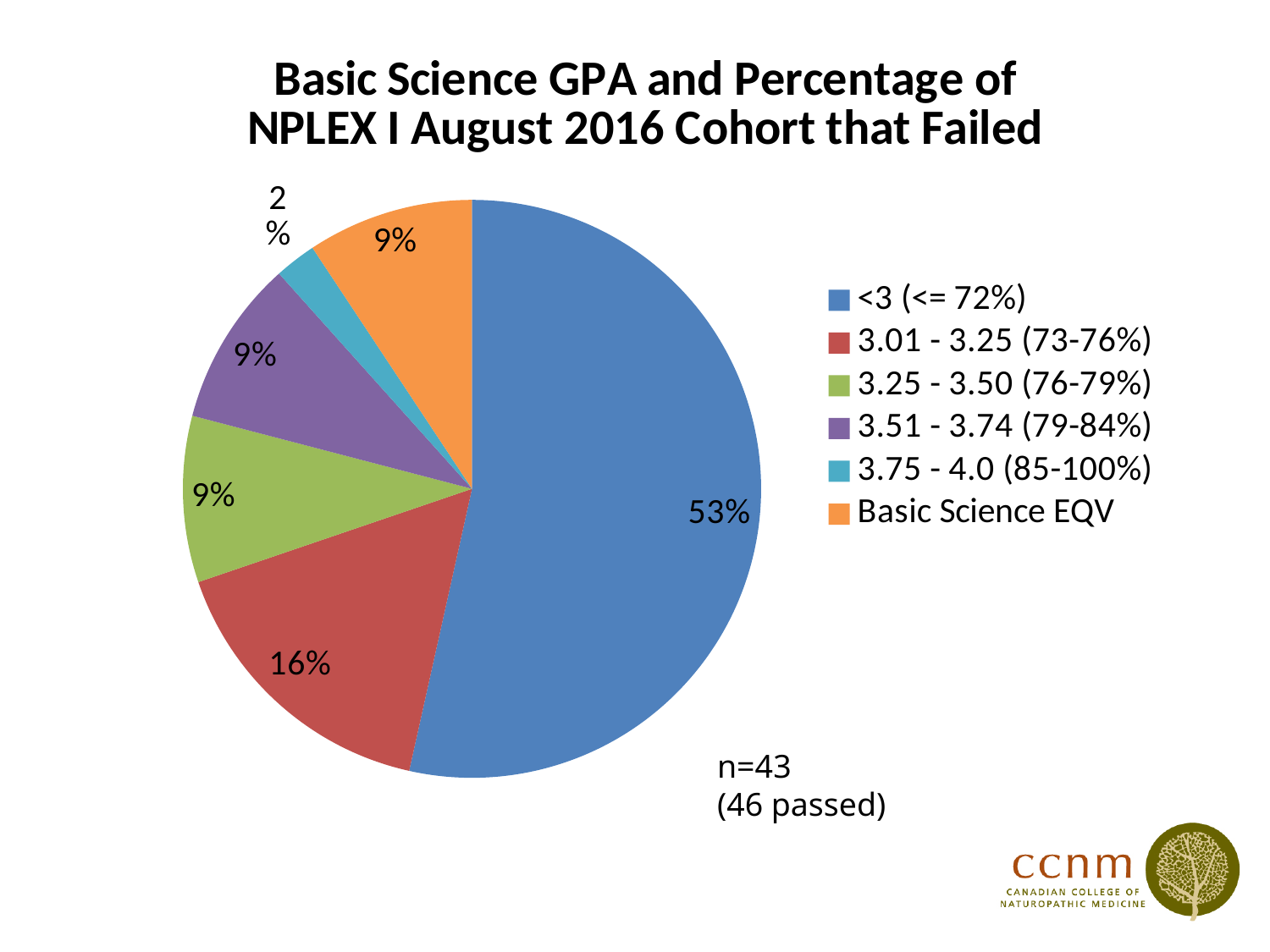
Which is larger, the 3.01 - 3.25 (73-76%) slice or the 3.51 - 3.74 (79-84%) slice? 3.01 - 3.25 (73-76%) What is the title of the chart? Basic Science GPA and Percentage of NPLEX I August 2016 Cohort that Failed What share of the pie does the 3.75 - 4.0 (85-100%) category have? 2% Which category has the smallest slice of the pie? 3.75 - 4.0 (85-100%) What kind of chart is shown on the slide? pie chart What is the difference in percentage points between the <3 (<= 72%) slice and the 3.01 - 3.25 (73-76%) slice? 37 What share of the pie does the <3 (<= 72%) category have? 53% What share of the pie does the Basic Science EQV category have? 9% Which category has the largest slice of the pie? <3 (<= 72%) How many categories does the legend list? 6 What colour is the slice for the 3.25 - 3.50 (76-79%) category? green